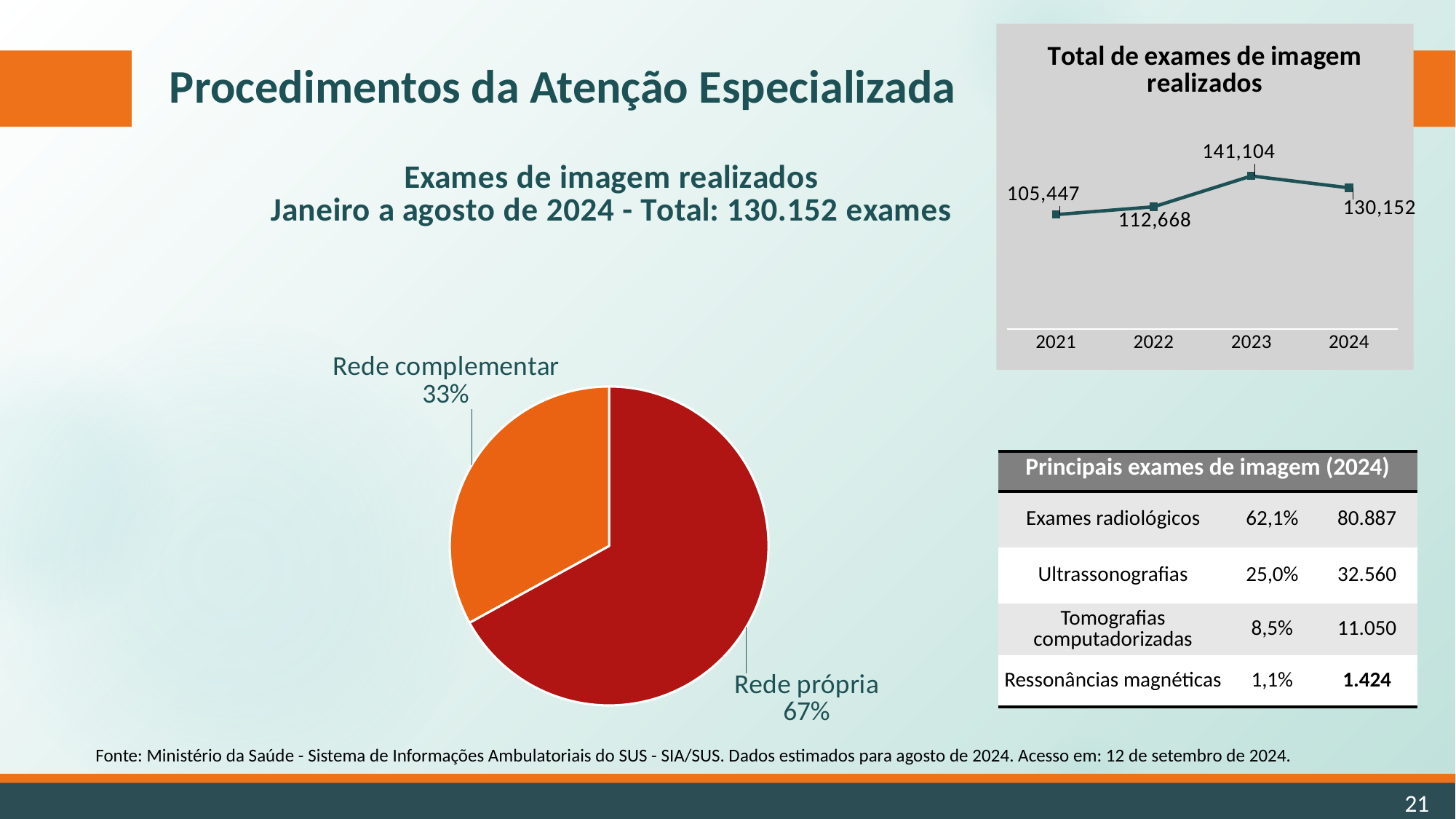
In the chart 'Total de exames de imagem realizados', what is the value for 2021? 105,447 In the chart 'Total de exames de imagem realizados', what is the difference between the 2023 and 2024 values? 10,952 In the pie chart 'Exames de imagem realizados', what share is labelled for Rede complementar? 33% In the pie chart 'Exames de imagem realizados', how many slices are there? 2 In the pie chart 'Exames de imagem realizados', what is the difference in percentage points between Rede própria and Rede complementar? 34 percentage points What kind of chart is 'Total de exames de imagem realizados'? Line chart In the chart 'Total de exames de imagem realizados', which year has the lowest value? 2021 What kind of chart is the one on the left showing Rede própria and Rede complementar? Pie chart In the chart 'Total de exames de imagem realizados', which year has the highest value? 2023 In the pie chart 'Exames de imagem realizados', what share is labelled for Rede própria? 67% In the pie chart 'Exames de imagem realizados', which slice is the largest? Rede própria In the chart 'Total de exames de imagem realizados', what is the value for 2023? 141,104